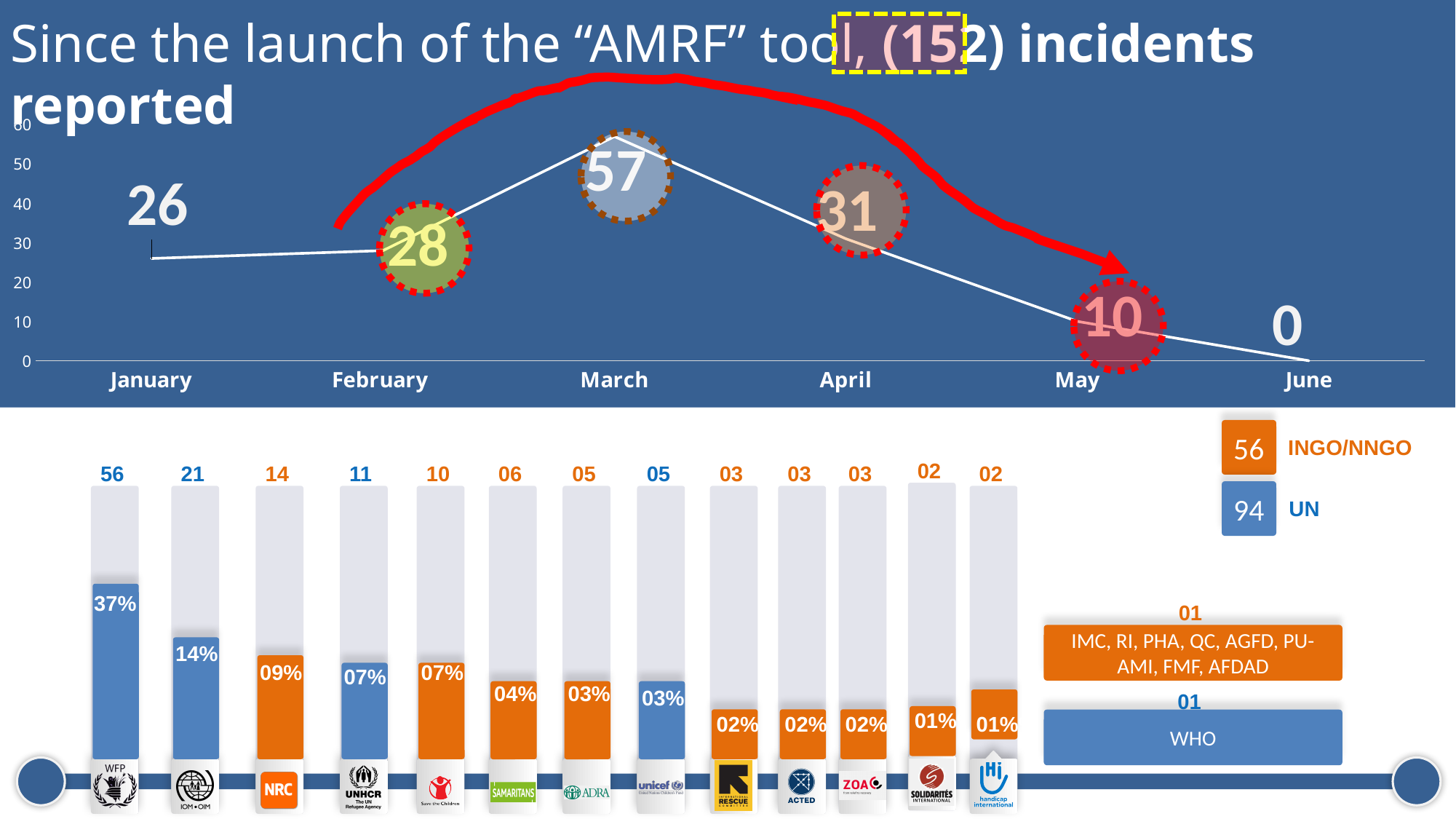
In the top line chart, what is the difference between the March and April values? 26 In the top line chart, which month has the lowest number of incidents? June In the top line chart, how many months are plotted on the x axis? 6 In the bottom bar chart, what percentage is shown on the NRC bar? 09% In the bottom bar chart, how many series does the legend list? 2 In the top line chart, which month has the larger value, January or February? February In the bottom bar chart, what is the value shown above the WFP bar? 56 In the top line chart, do the values rise or fall from March to June? fall In the top line chart, which month has the highest number of incidents? March In the top line chart, how many incidents were reported in March? 57 In the bottom bar chart, what is the difference between the WFP value and the IOM value? 35 What kind of chart is the top chart showing incidents by month? line chart